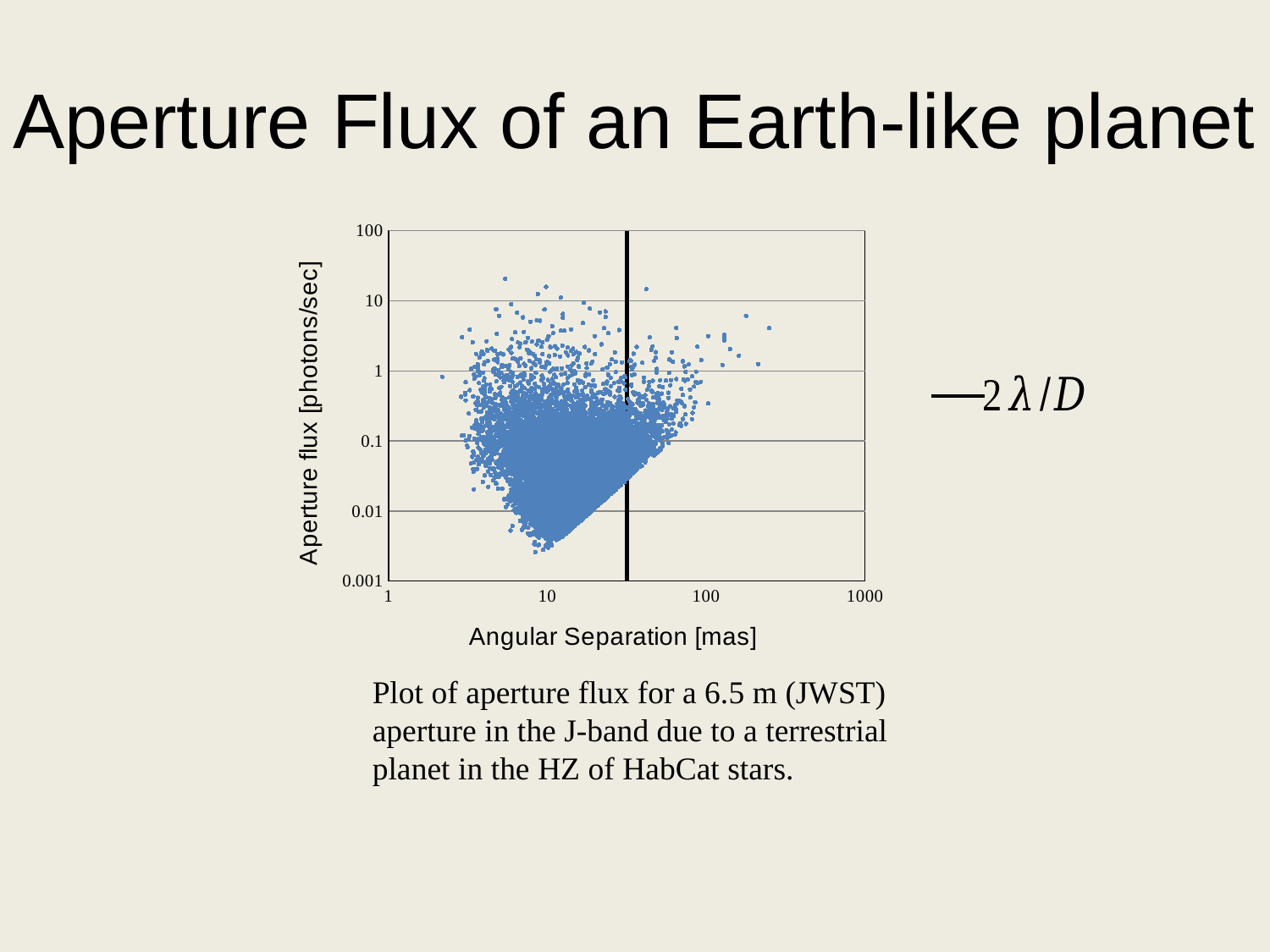
What is the highest tick value shown on the y-axis? 100 Is the aperture flux of the highest plotted point greater or less than 10 photons/sec? greater What is the highest tick value shown on the x-axis? 1000 What kind of chart is shown on the slide? Scatter plot Is the vertical black line (2λ/D) at an angular separation greater or less than 10 mas? greater What entry does the legend next to the chart show? 2λ/D Is the aperture flux of the lowest plotted point greater or less than 0.01 photons/sec? less What is the lowest tick value shown on the y-axis? 0.001 How many entries does the legend list? 1 What is the label of the y-axis of the chart? Aperture flux [photons/sec]